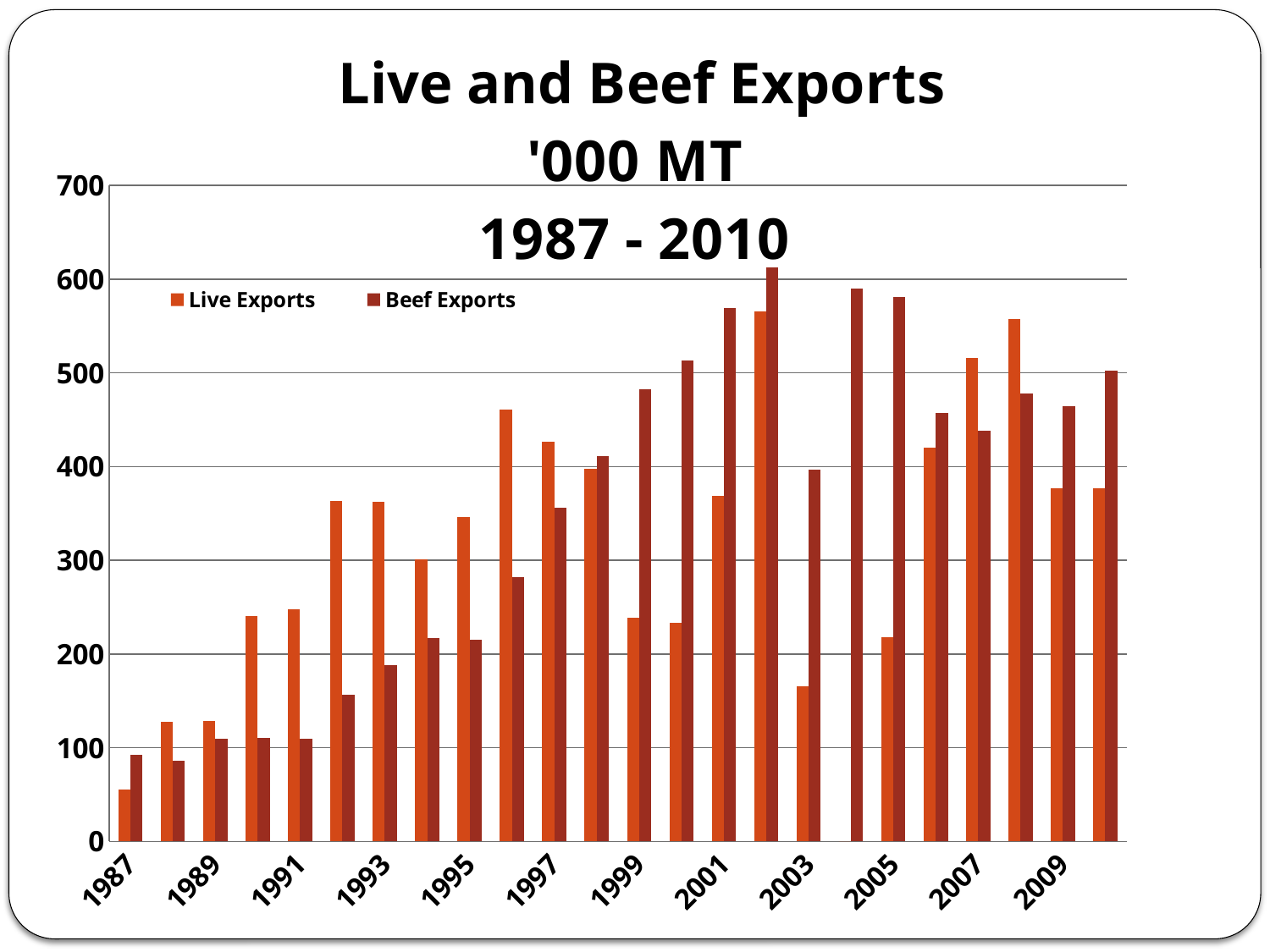
Is the value for Beef Exports in 2002 greater or less than 600? greater In 1999, which is larger: Live Exports or Beef Exports? Beef Exports In 1993, which is larger: Live Exports or Beef Exports? Live Exports What kind of chart is shown on the slide? bar chart Is the value for Beef Exports in 2000 greater or less than 500? greater Is the value for Live Exports in 2003 greater or less than 200? less Do Beef Exports generally rise or fall from 1987 to 2002? rise How many series does the legend list? 2 What is the title of the chart? Live and Beef Exports '000 MT 1987 - 2010 In which year are Beef Exports highest? 2002 What are the two series named in the legend? Live Exports and Beef Exports